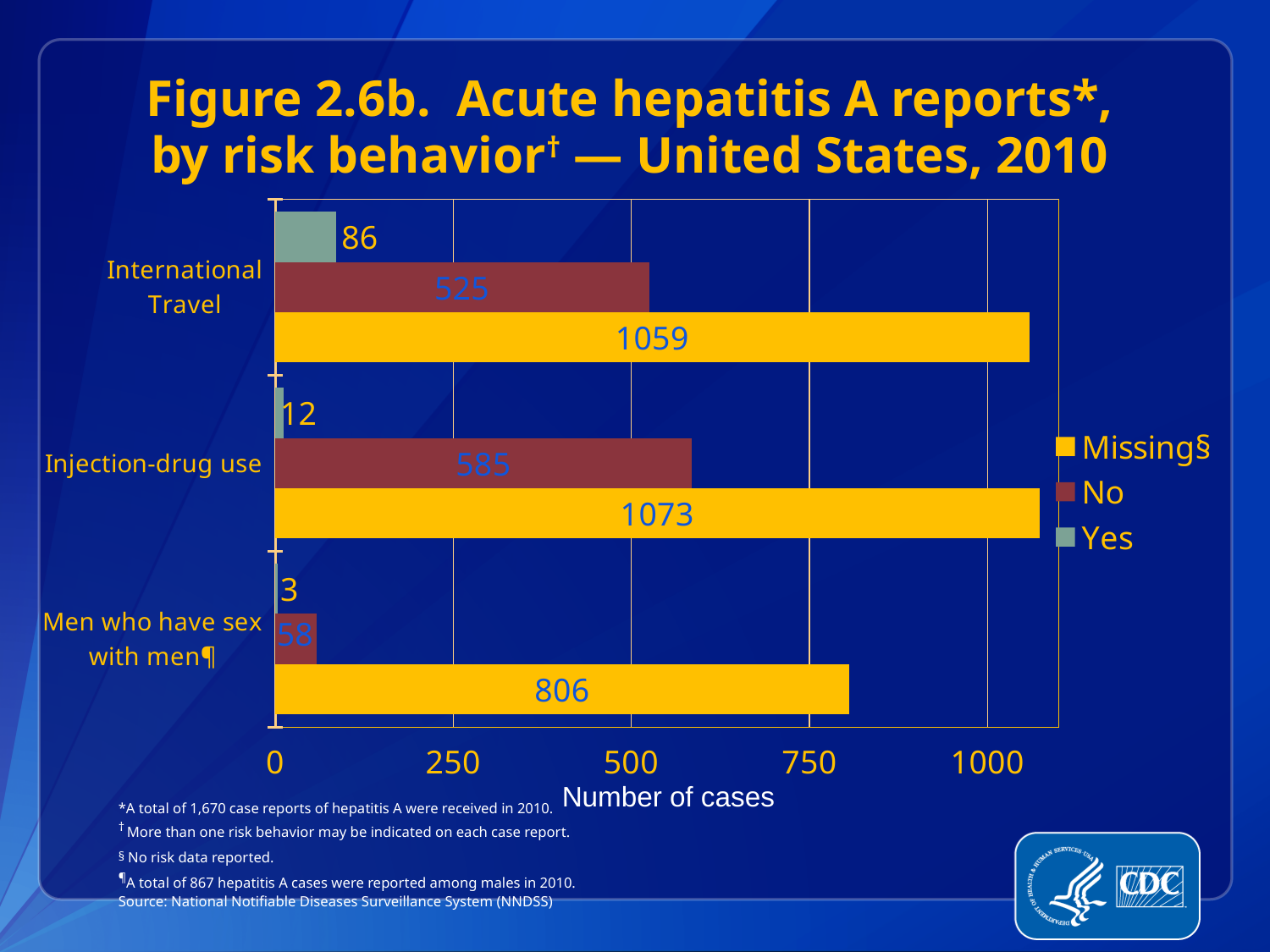
Which is larger: the Missing value for International Travel or the Missing value for Men who have sex with men? International Travel What is the number of cases for Injection-drug use in the Missing series? 1073 What is the label of the x axis? Number of cases How many series does the legend list? 3 Which risk behavior has the lowest value in the Missing series? Men who have sex with men What is the difference between the No values for Injection-drug use and International Travel? 60 What kind of chart is shown on the slide? bar chart What is the number of cases for Men who have sex with men in the No series? 58 Is the No value for International Travel greater or less than 500? greater What is the number of cases for International Travel in the Yes series? 86 How many risk behavior categories are shown on the chart? 3 Which risk behavior has the highest value in the Yes series? International Travel